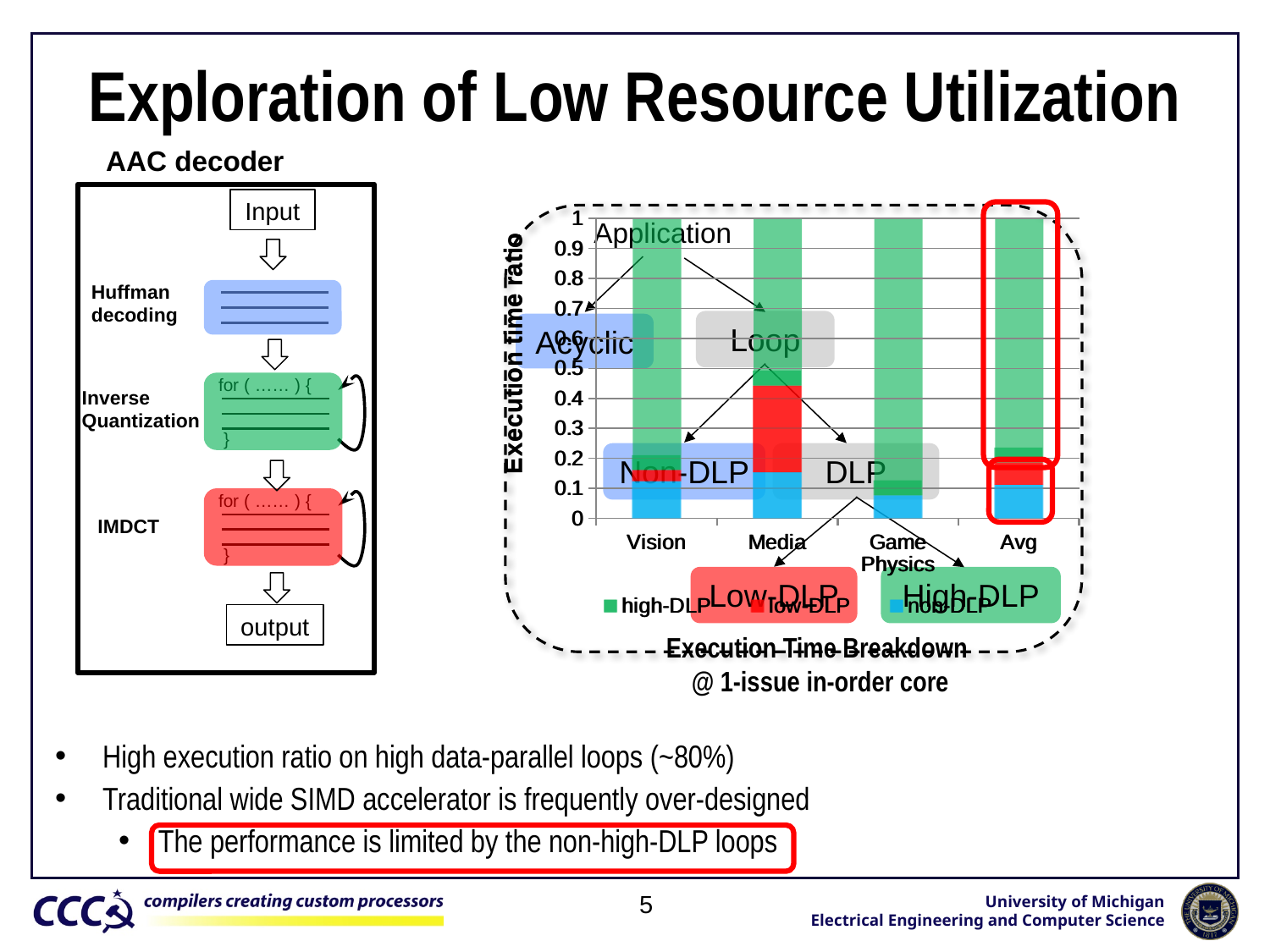
What are the three series listed in the chart legend? high-DLP, low-DLP, non-DLP Which category has the largest low-DLP portion in the chart? Media What kind of chart is shown on the slide? Stacked bar chart Is the high-DLP portion for Media greater or less than 0.7? less Is the low-DLP portion larger for Media or for Vision? Media What is the label of the y axis of the chart? Execution time ratio How many series does the chart legend list? 3 How many application categories are shown on the x axis of the chart? 4 Which category has the smallest high-DLP portion in the chart? Media Is the non-DLP portion for Vision greater or less than 0.2? less Is the high-DLP portion for Game Physics greater or less than 0.8? greater What is the total height of the stacked bar for Vision? 1